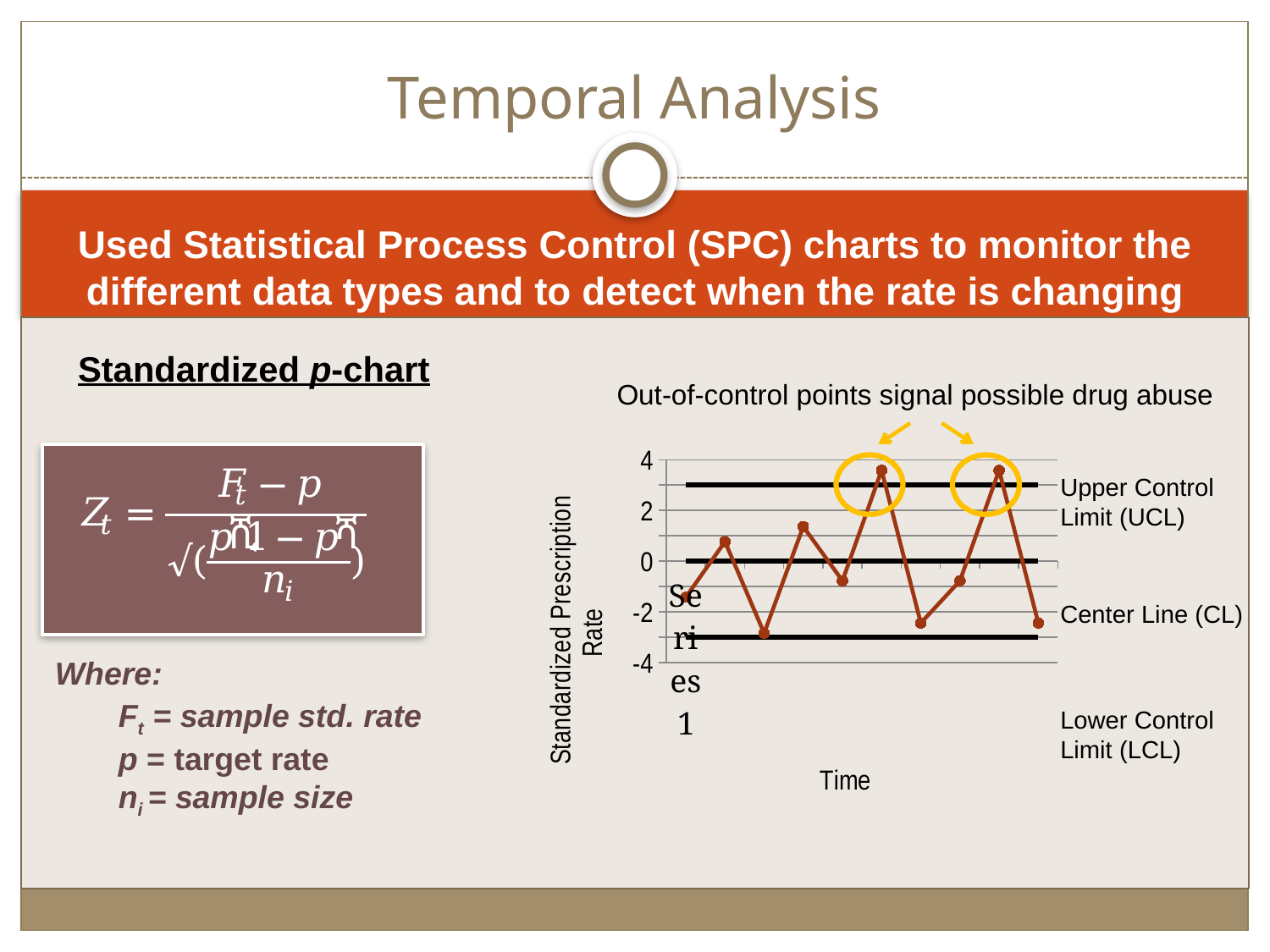
What kind of chart is shown on the slide? line chart What is the highest value shown on the vertical axis of the chart? 4 Is the value of the sixth plotted point greater or less than 2? greater Is the value of the second plotted point greater or less than 0? greater Is the value of the last plotted point greater or less than 0? less What is the title of the horizontal axis of the chart? Time What is the title of the vertical axis of the chart? Standardized Prescription Rate How many data points are plotted on the line in the chart? 10 Which is larger, the value of the second plotted point or the value of the third plotted point? the second plotted point How many points on the chart are circled as out-of-control points? 2